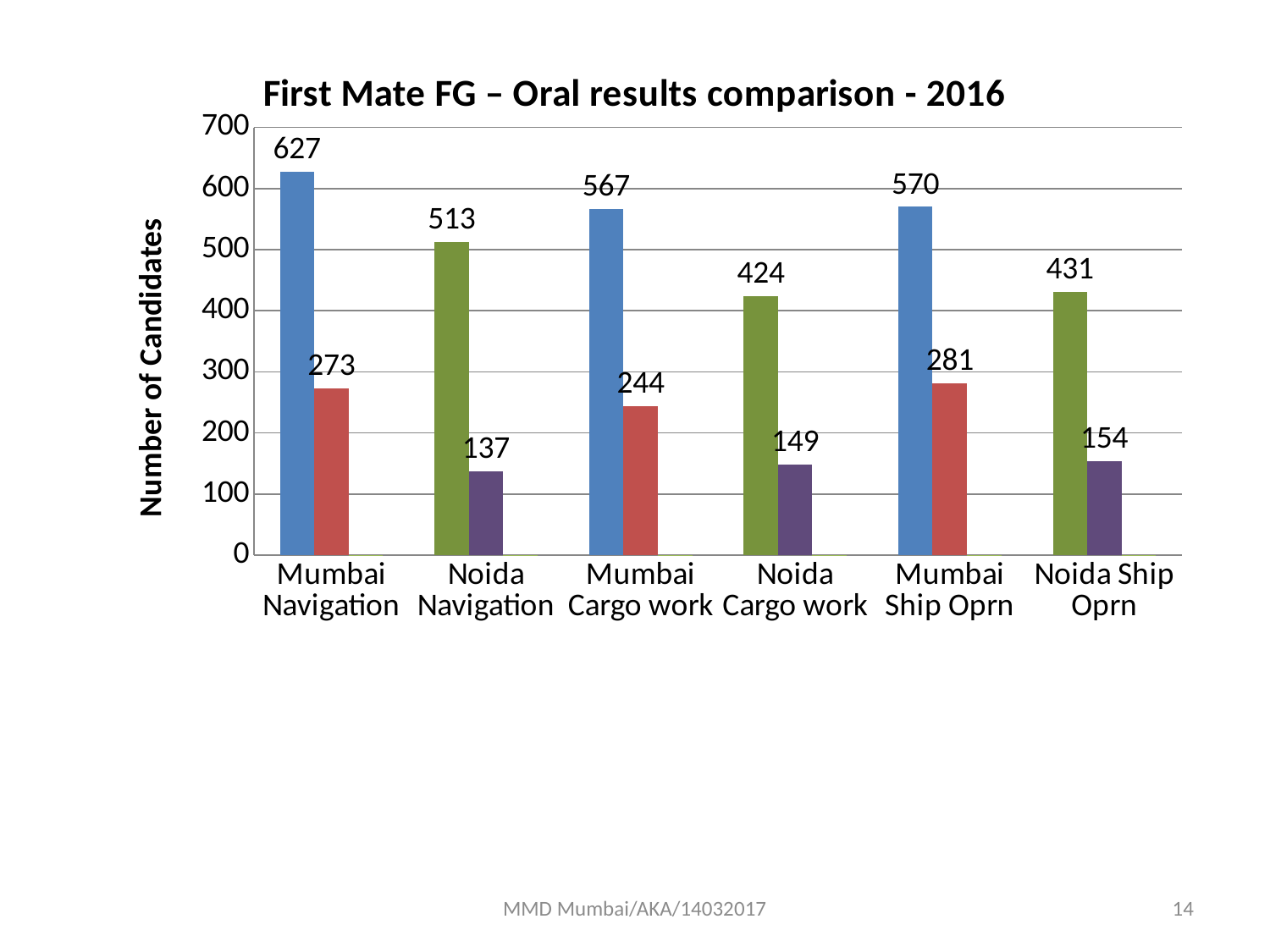
What is the difference between the two bars for Mumbai Navigation (627 and 273)? 354 What is the title of the chart? First Mate FG – Oral results comparison - 2016 What is the value of the red bar for Mumbai Ship Oprn? 281 Which category has the highest value shown on the chart? Mumbai Navigation Which category has the lowest value shown on the chart? Noida Navigation What kind of chart is shown on the slide? Bar chart What is the difference between the blue bar for Mumbai Cargo work and the green bar for Noida Cargo work? 143 How many categories are shown on the x axis? 6 What is the value of the green bar for Noida Ship Oprn? 431 Which is larger: the green bar for Noida Navigation or the green bar for Noida Ship Oprn? Noida Navigation What is the value of the purple bar for Noida Cargo work? 149 What is the value of the blue bar for Mumbai Navigation? 627